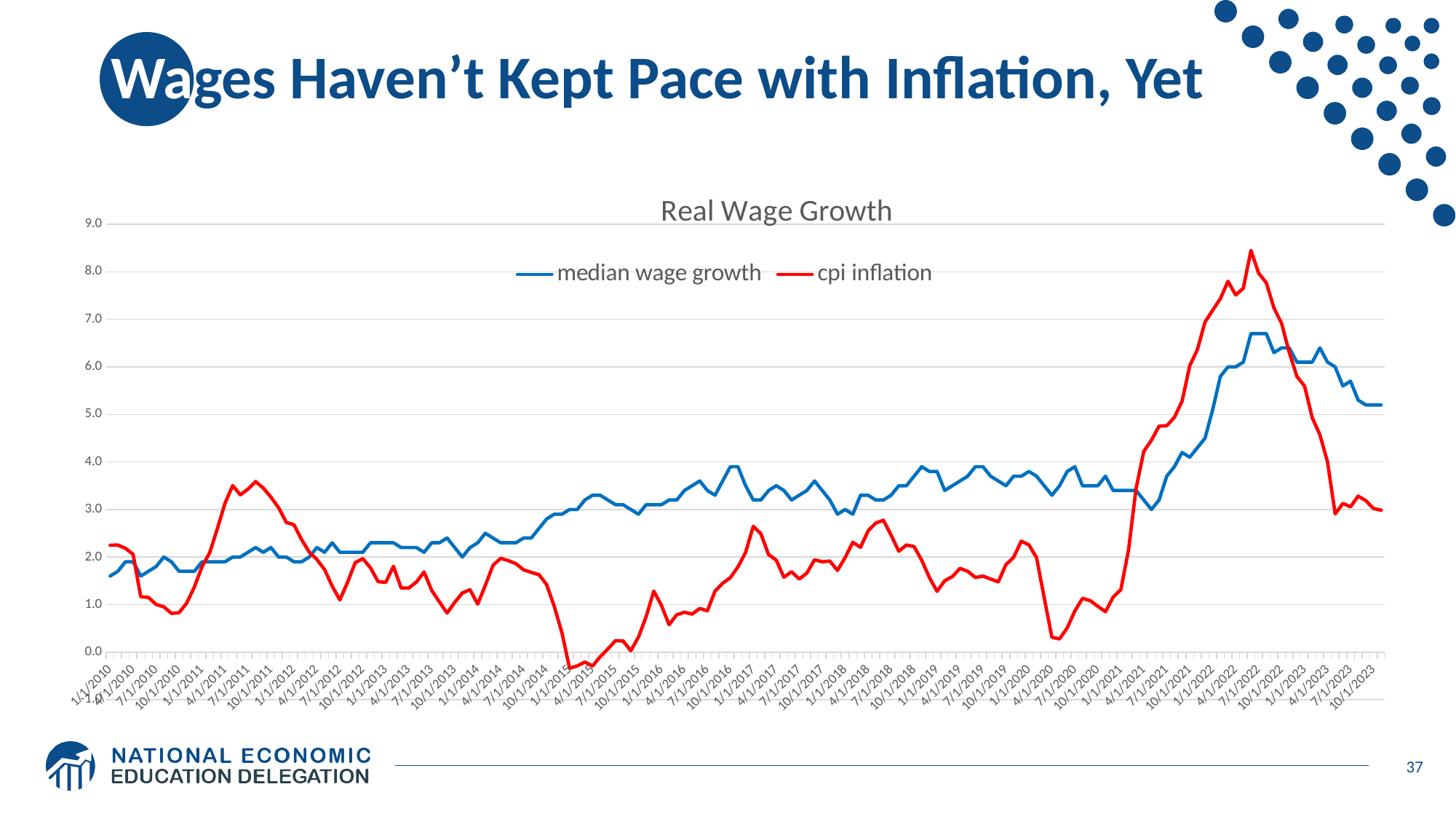
Does cpi inflation rise or fall between 7/1/2022 and 10/1/2023? fall At 1/1/2015, which series has the higher value, median wage growth or cpi inflation? median wage growth Is the value of cpi inflation at 4/1/2020 greater or less than 1.0? less What kind of chart is shown on the slide? line chart Is the value of median wage growth at 1/1/2010 greater or less than 2.0? less How many series does the legend of the Real Wage Growth chart list? 2 Is the value of cpi inflation at 7/1/2022 greater or less than 7.0? greater Which colour is used for the cpi inflation line? red What is the title of the chart on the slide? Real Wage Growth Which series reaches the highest peak on the chart, median wage growth or cpi inflation? cpi inflation At 7/1/2022, which series has the higher value, median wage growth or cpi inflation? cpi inflation